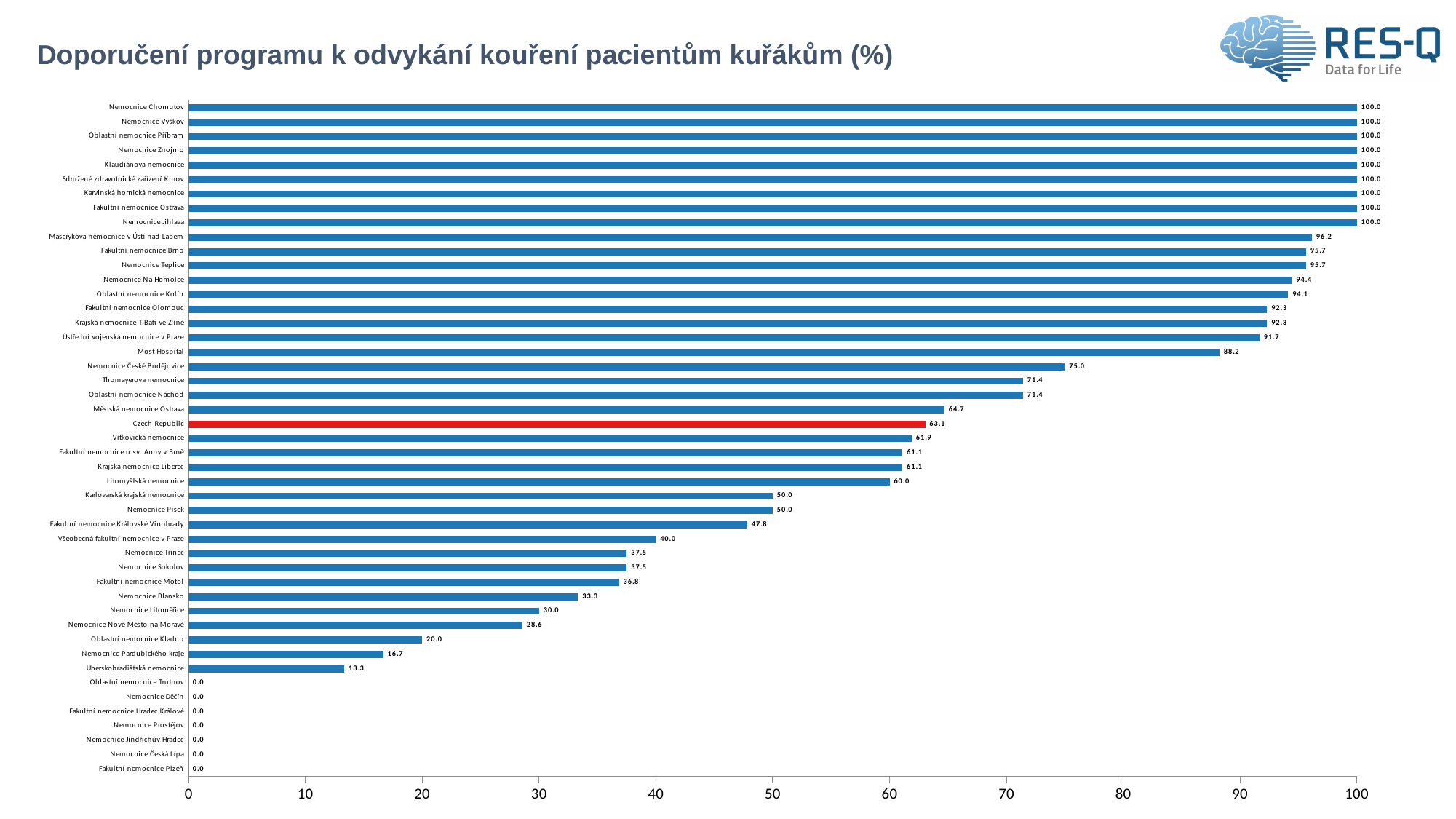
What kind of chart is shown on the slide? bar chart What is the value for Most Hospital? 88.2 Which bar is highlighted in red? Czech Republic What is the value for Czech Republic? 63.1 What is the difference between the values for Nemocnice České Budějovice and Czech Republic? 11.9 How many categories have a value of 0.0? 7 Is the value for Všeobecná fakultní nemocnice v Praze greater or less than 50? less What is the value for Fakultní nemocnice Motol? 36.8 How many hospitals have a value of 100.0? 9 What is the title of the chart? Doporučení programu k odvykání kouření pacientům kuřákům (%) What is the value for Uherskohradišťská nemocnice? 13.3 Which has a larger value, Nemocnice Blansko or Nemocnice Litoměřice? Nemocnice Blansko